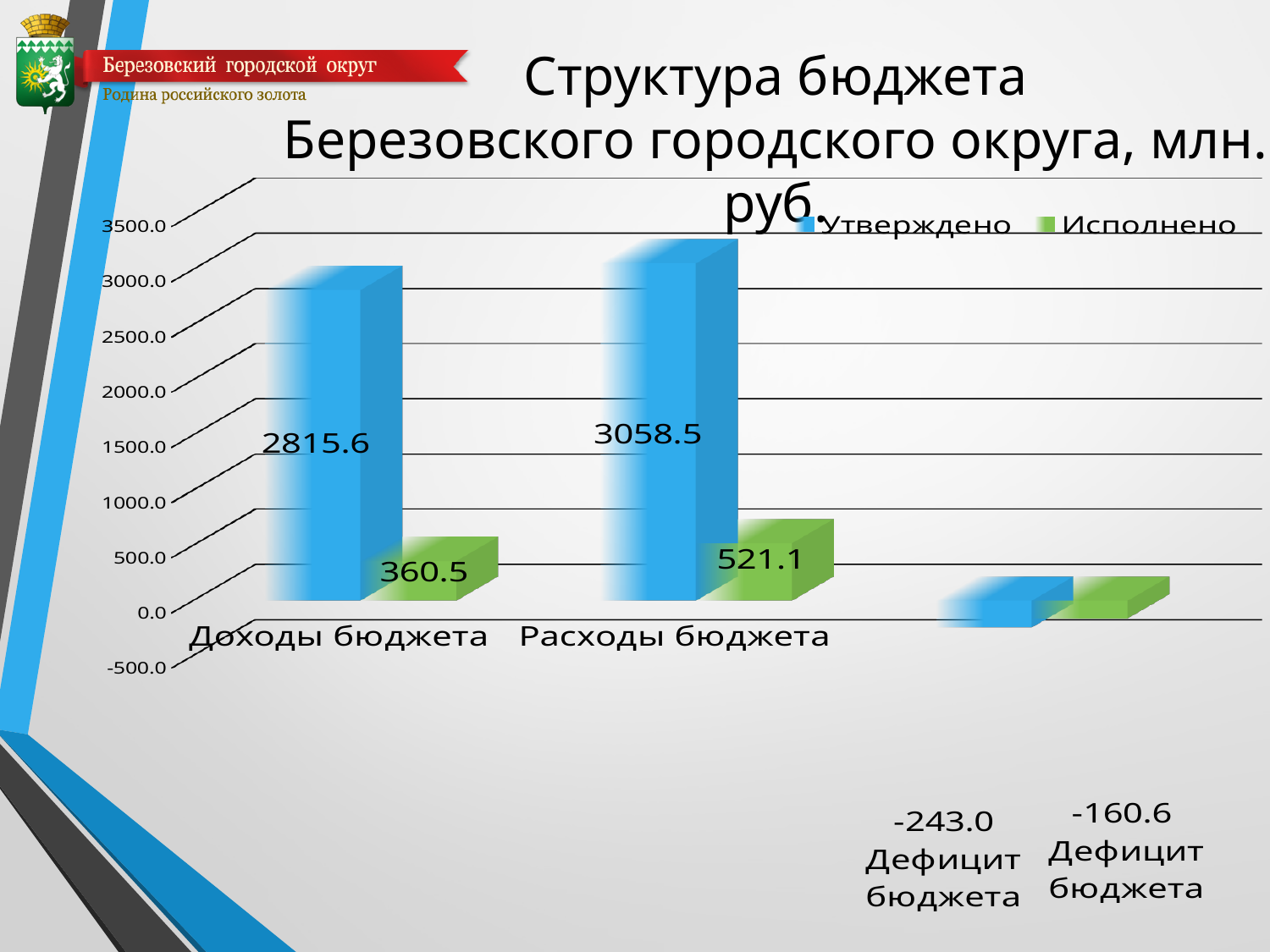
What is the difference between the Утверждено values for Расходы бюджета and Доходы бюджета? 242.9 What is the Исполнено value for Дефицит бюджета? -160.6 What is the Исполнено value for Расходы бюджета? 521.1 What colour represents the Исполнено series? Green What kind of chart is shown on the slide? Bar chart What is the Исполнено value for Доходы бюджета? 360.5 How many series does the legend list? 2 Which is larger: the Исполнено value for Расходы бюджета or for Доходы бюджета? Расходы бюджета Which category has the highest Утверждено value? Расходы бюджета What is the Утверждено value for Доходы бюджета? 2815.6 Which category has the lowest Исполнено value? Дефицит бюджета What is the Утверждено value for Дефицит бюджета? -243.0